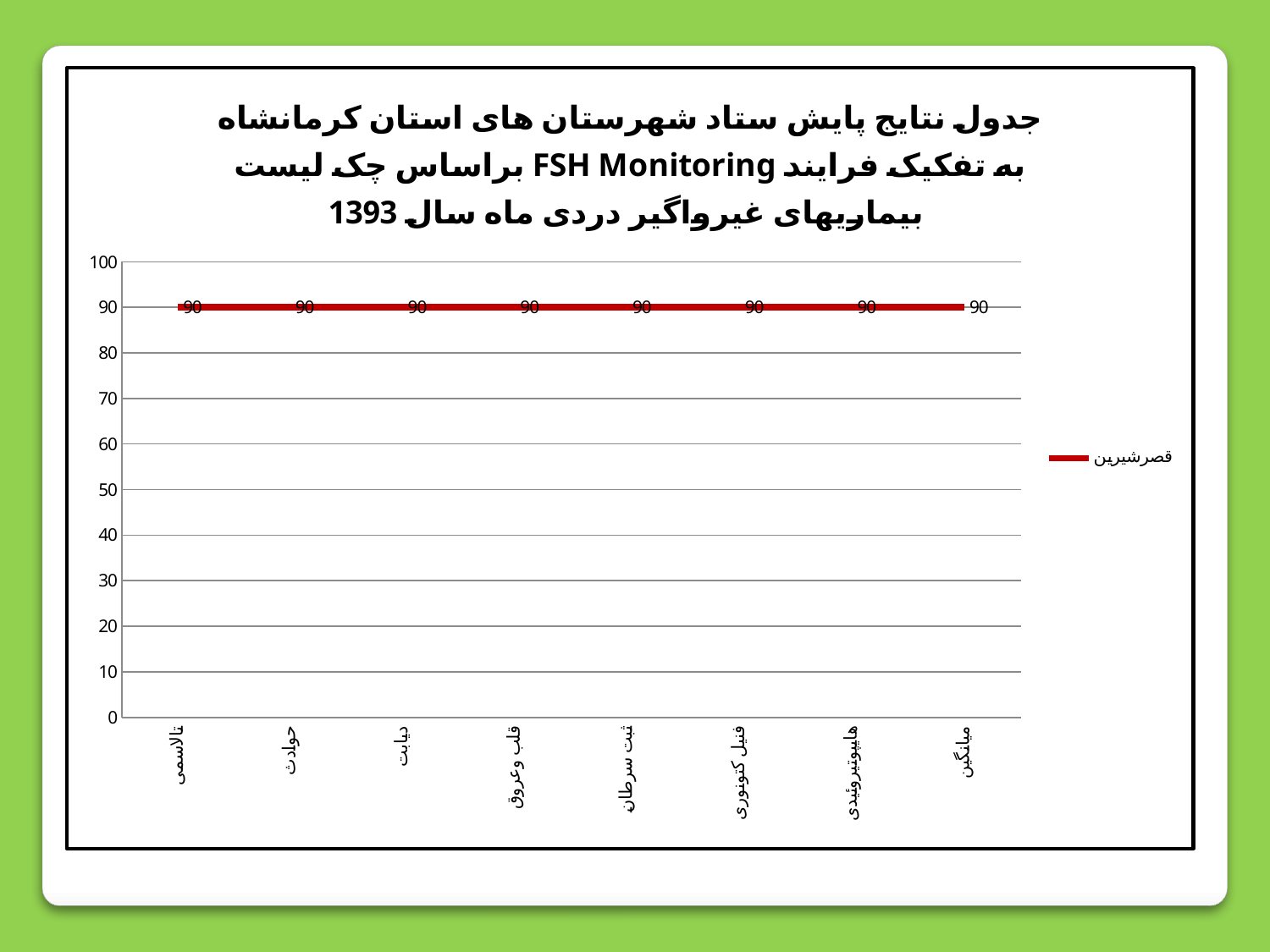
What kind of chart is this? line chart What is the value for میانگین? 90 What colour is the plotted line? red What is the value for دیابت? 90 How many categories are shown on the x axis? 8 What is the value for تالاسمی? 90 What is the difference between the values for حوادث and ثبت سرطان? 0 How many series does the legend list? 1 Is the value for قلب وعروق greater or less than 80? greater What is the value for فنیل کتونوری? 90 Do the values rise, fall, or stay flat across the x axis? stay flat What series name is shown in the legend? قصرشیرین